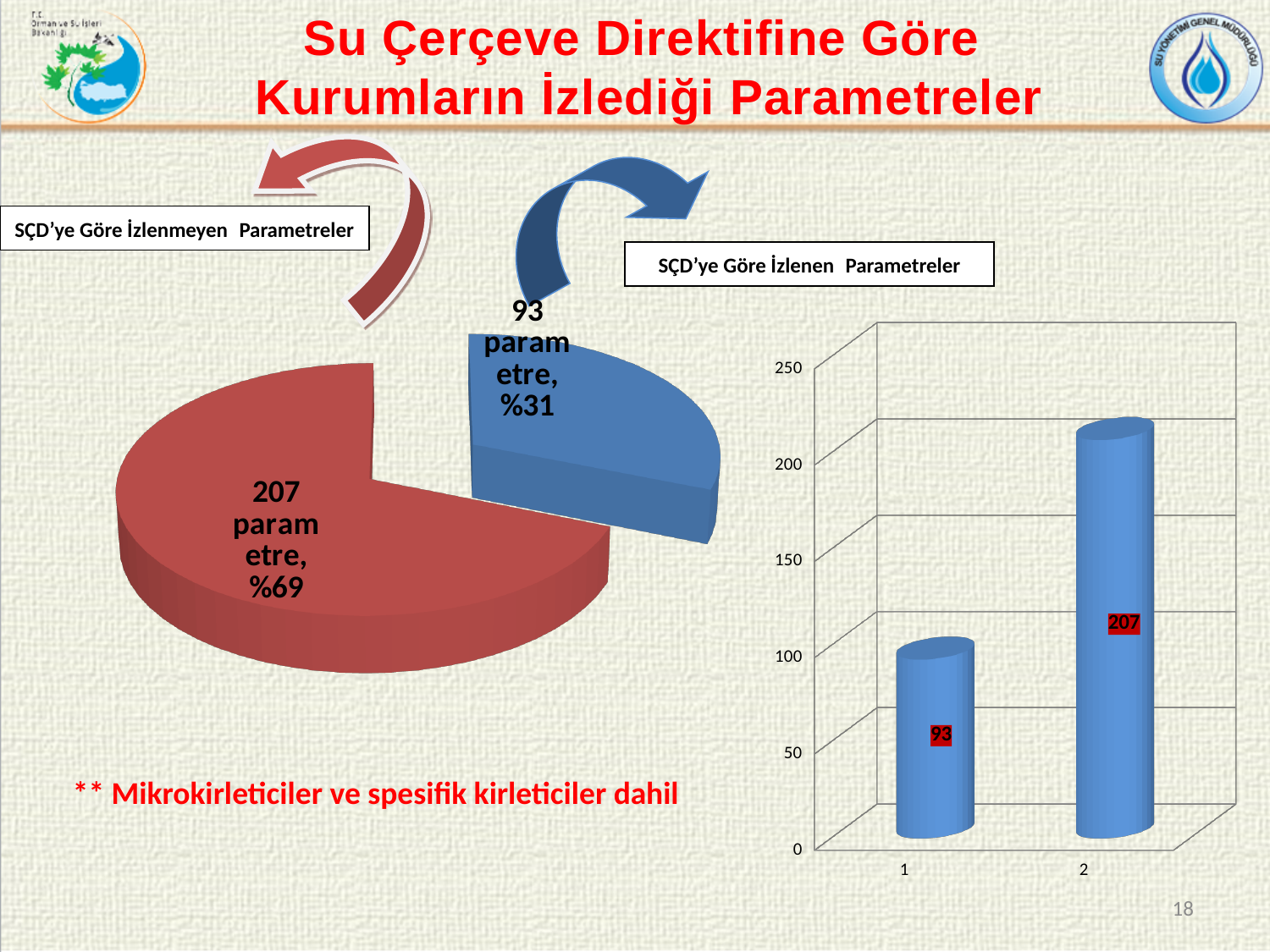
What kind of chart is the chart on the right of the slide? bar chart On the bar chart on the right, which category has the lowest value? 1 How many bars are shown on the bar chart on the right? 2 What kind of chart is the chart on the left of the slide? pie chart On the pie chart on the left, what percentage share does the blue slice labelled 93 parametre have? %31 On the bar chart on the right, what is the value for category 1? 93 On the pie chart on the left, what percentage share does the red slice labelled 207 parametre have? %69 On the bar chart on the right, is the value for category 2 greater or less than 150? greater How many slices does the pie chart on the left have? 2 On the bar chart on the right, which category has the highest value? 2 On the bar chart on the right, what is the value for category 2? 207 On the bar chart on the right, what is the difference between the values for category 2 and category 1? 114